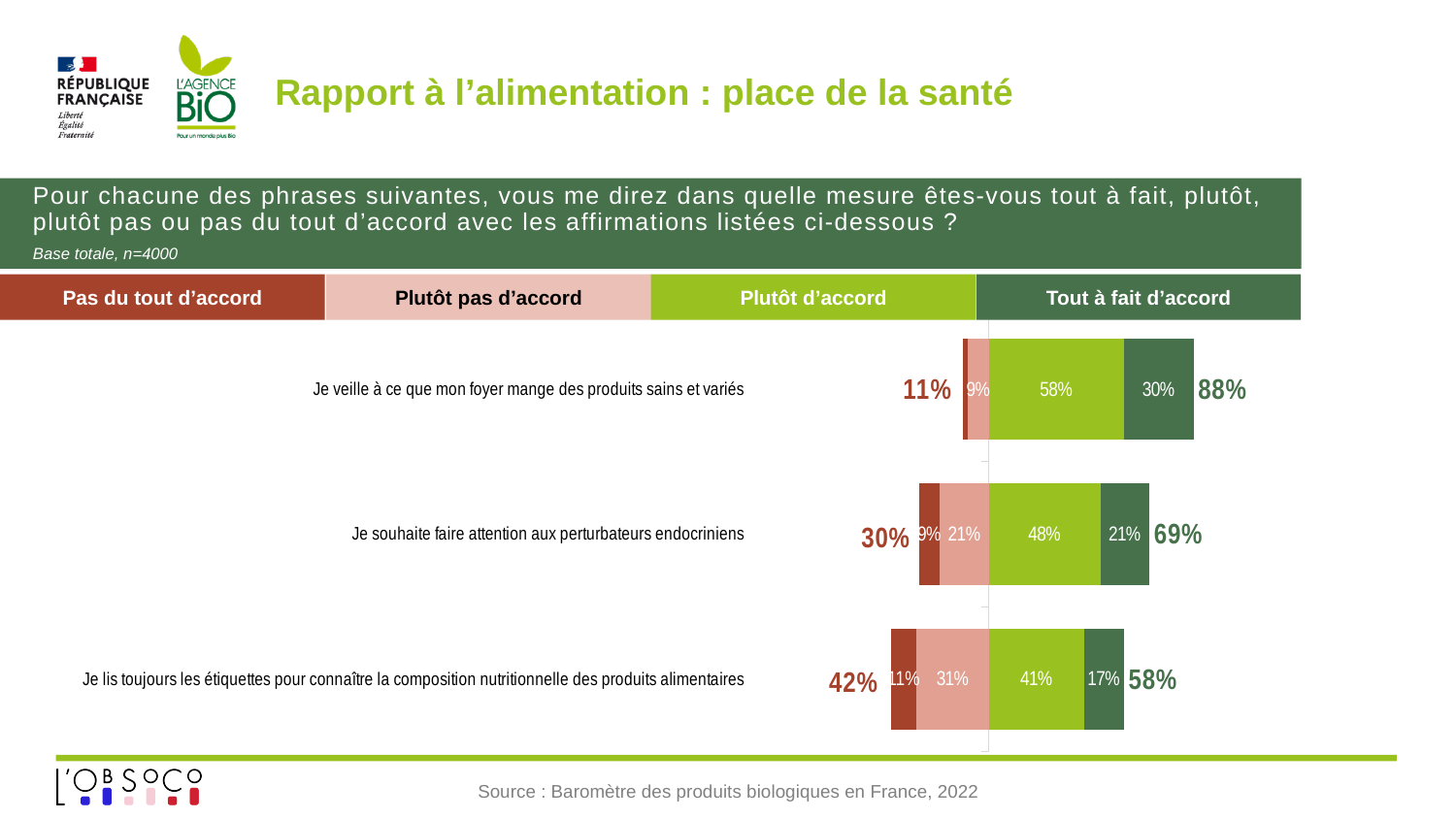
What is the 'Plutôt d'accord' value for 'Je veille à ce que mon foyer mange des produits sains et variés'? 58% How many statements (categories) are plotted in the chart? 3 What is the difference between the 'Plutôt d'accord' values for 'Je veille à ce que mon foyer mange des produits sains et variés' and 'Je souhaite faire attention aux perturbateurs endocriniens'? 10 percentage points How many response levels does the legend list? 4 Which is larger: the 'Pas du tout d'accord' value for 'Je souhaite faire attention aux perturbateurs endocriniens' or for 'Je lis toujours les étiquettes pour connaître la composition nutritionnelle des produits alimentaires'? Je lis toujours les étiquettes pour connaître la composition nutritionnelle des produits alimentaires Which statement has the highest 'Tout à fait d'accord' value? Je veille à ce que mon foyer mange des produits sains et variés What is the combined disagreement total shown for 'Je lis toujours les étiquettes pour connaître la composition nutritionnelle des produits alimentaires'? 42% Which statement has the lowest 'Plutôt d'accord' value? Je lis toujours les étiquettes pour connaître la composition nutritionnelle des produits alimentaires What type of chart is shown on the slide? stacked bar chart What is the 'Plutôt pas d'accord' value for 'Je lis toujours les étiquettes pour connaître la composition nutritionnelle des produits alimentaires'? 31% What is the 'Tout à fait d'accord' value for 'Je souhaite faire attention aux perturbateurs endocriniens'? 21% What is the combined agreement total (Plutôt d'accord + Tout à fait d'accord) shown for 'Je veille à ce que mon foyer mange des produits sains et variés'? 88%